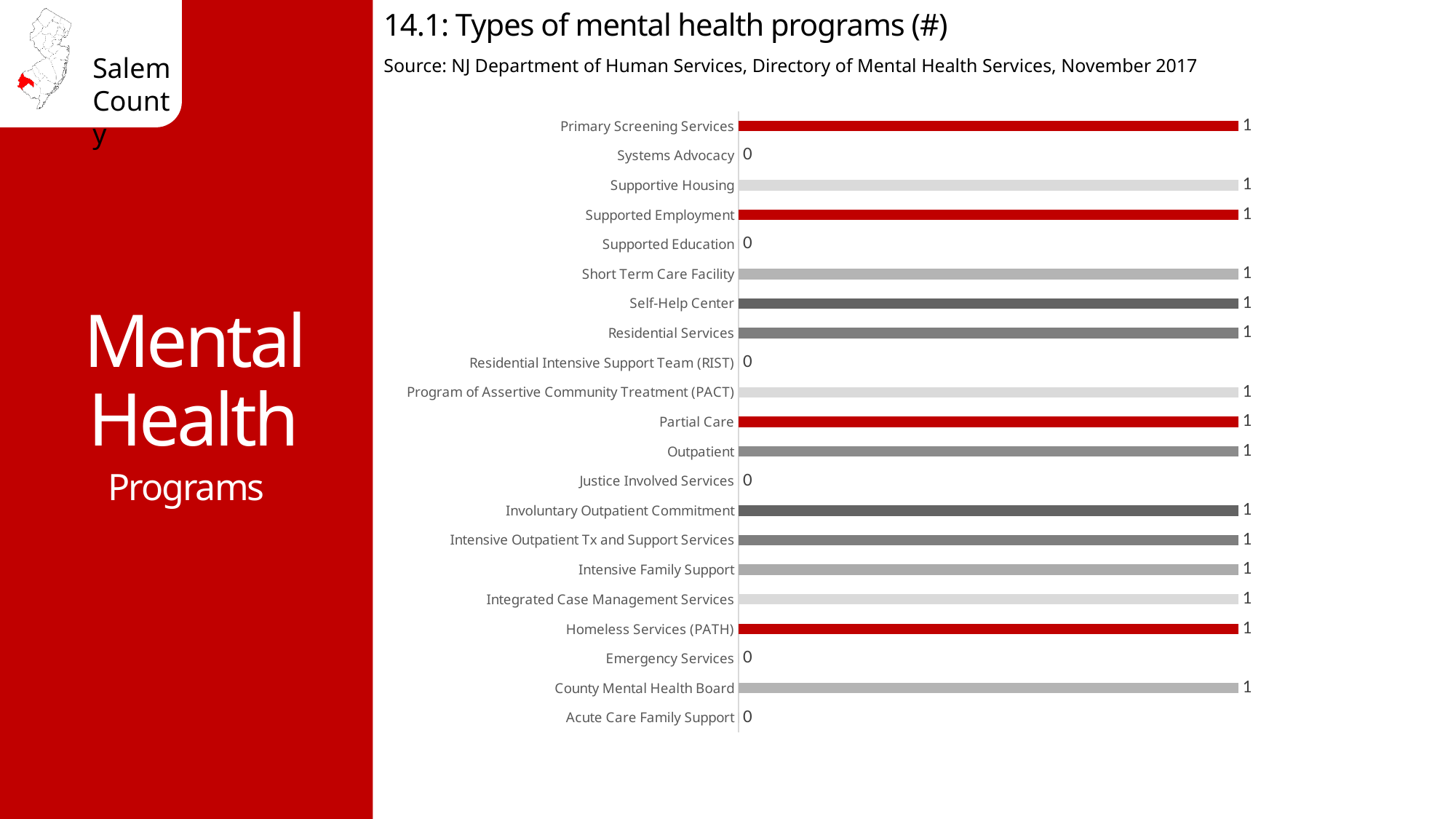
Which is larger, the value for Partial Care or the value for Justice Involved Services? Partial Care What is the value for Program of Assertive Community Treatment (PACT)? 1 What is the title of the chart? 14.1: Types of mental health programs (#) What is the value for Homeless Services (PATH)? 1 What kind of chart is shown on the slide? Bar chart What is the value for Primary Screening Services? 1 What is the value for Acute Care Family Support? 0 How many categories have a value of 0? 6 What is the value for Systems Advocacy? 0 How many categories are shown on the chart? 21 What is the difference between the value for Outpatient and the value for Supported Education? 1 What is the value for Emergency Services? 0